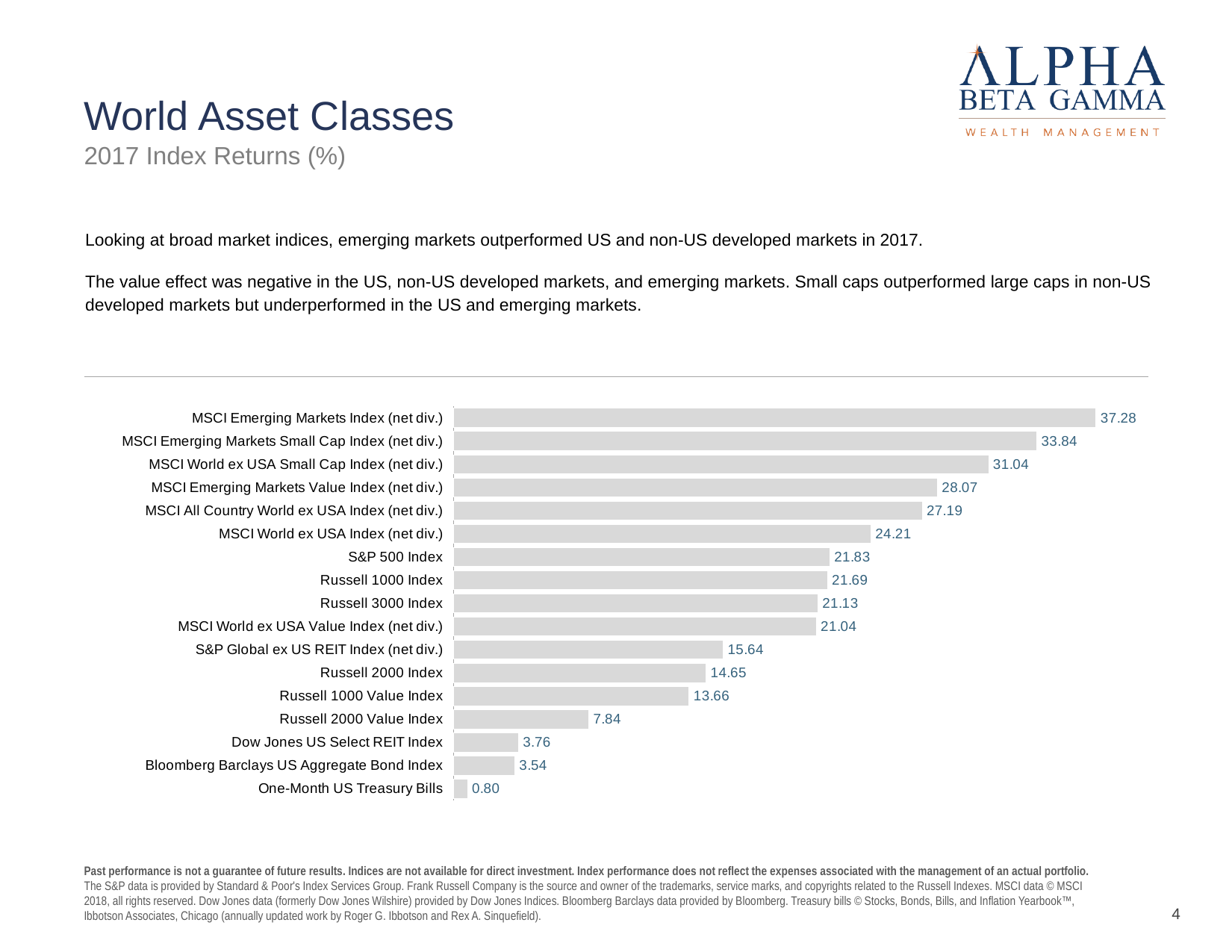
What is the difference between the MSCI Emerging Markets Index (net div.) and the S&P 500 Index values? 15.45 Which index has the highest 2017 return on the chart? MSCI Emerging Markets Index (net div.) What is the difference between the Russell 2000 Index and the Russell 2000 Value Index values? 6.81 What value is shown for the Bloomberg Barclays US Aggregate Bond Index? 3.54 Which category has the lowest value on the chart? One-Month US Treasury Bills What is the value shown for the Russell 2000 Value Index? 7.84 What kind of chart is shown on the slide? Bar chart How many indices are plotted on the chart? 17 Which is larger, the value for the Russell 1000 Value Index or the Russell 2000 Index? Russell 2000 Index What value is shown for the S&P 500 Index? 21.83 Which is larger, the value for the MSCI World ex USA Small Cap Index (net div.) or the MSCI World ex USA Index (net div.)? MSCI World ex USA Small Cap Index (net div.) What is the 2017 return shown for the MSCI Emerging Markets Index (net div.)? 37.28